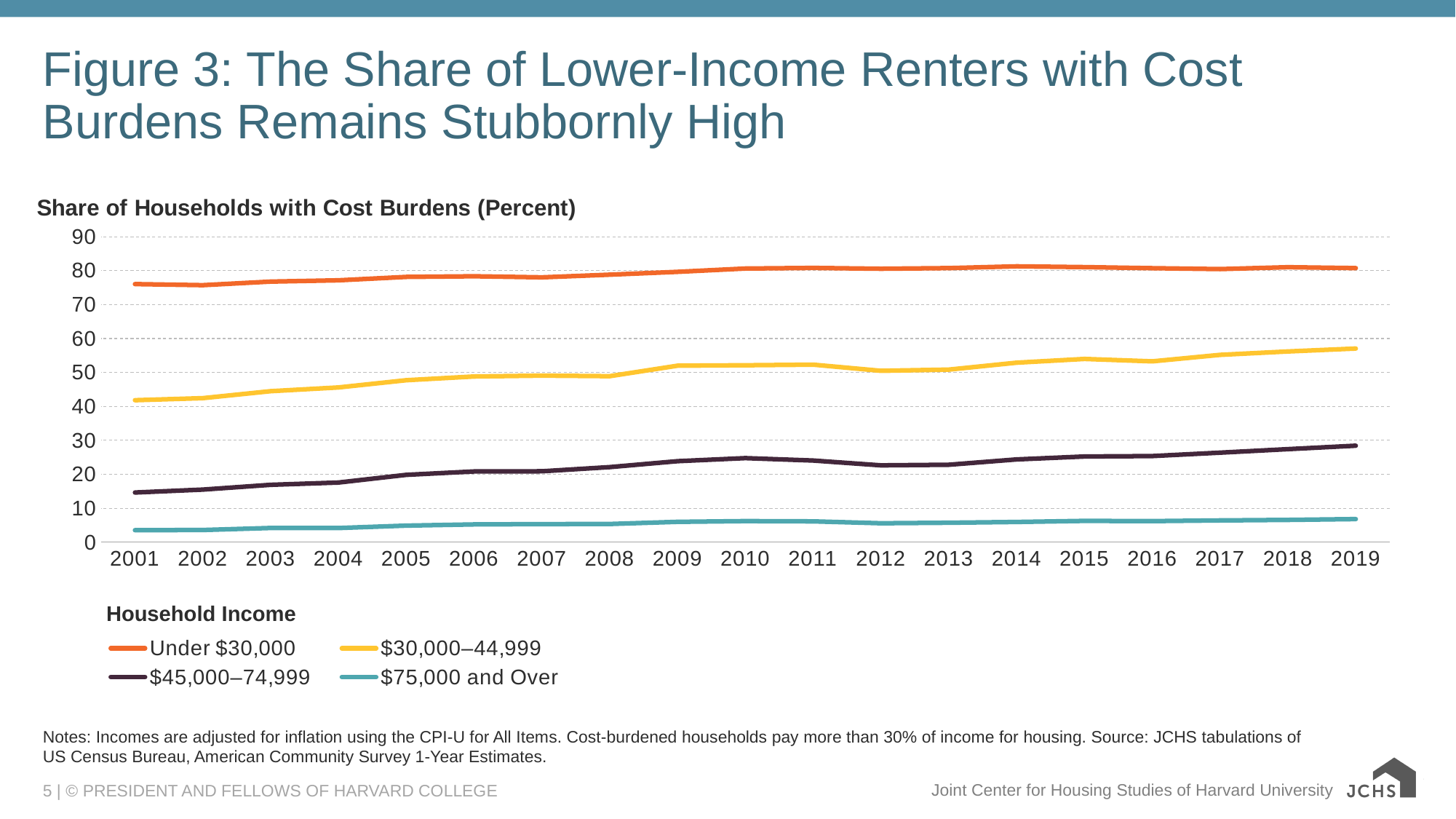
What kind of chart is shown on the slide? line chart Which household income group has the lowest share of households with cost burdens across the whole period? $75,000 and Over Is the value for $75,000 and Over in 2010 greater or less than 10? less Which household income group has the highest share of households with cost burdens across the whole period? Under $30,000 For the $45,000–74,999 group, is the value larger in 2001 or in 2019? 2019 Is the value for $30,000–44,999 in 2001 greater or less than 50? less Is the value for $45,000–74,999 in 2019 greater or less than 20? greater How many years are plotted along the x axis? 19 How many series does the legend list? 4 Does the share for $30,000–44,999 rise or fall from 2001 to 2019? rise What is the title of the legend? Household Income